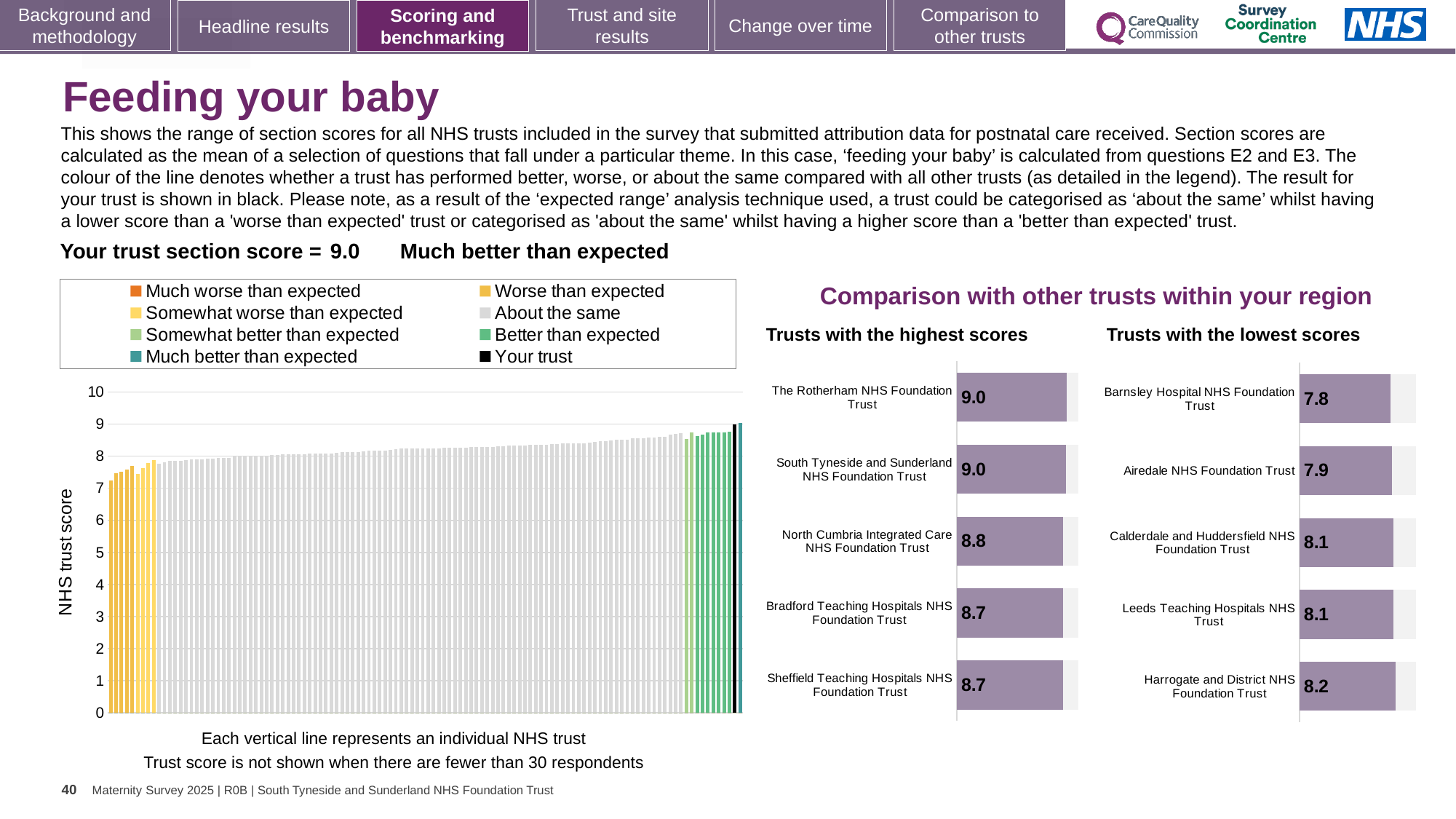
In the 'Trusts with the lowest scores' chart, what is the score for Leeds Teaching Hospitals NHS Trust? 8.1 How many trusts are shown in the 'Trusts with the highest scores' chart? 5 In the 'NHS trust score' chart on the left, is the value of the black 'Your trust' bar greater or less than 8? greater In the 'Trusts with the lowest scores' chart, what is the score for Barnsley Hospital NHS Foundation Trust? 7.8 In the 'Trusts with the lowest scores' chart, which has the larger score: Airedale NHS Foundation Trust or Harrogate and District NHS Foundation Trust? Harrogate and District NHS Foundation Trust In the 'NHS trust score' chart on the left, do the bar values rise or fall from left to right? Rise In the 'Trusts with the lowest scores' chart, which trust has the highest score? Harrogate and District NHS Foundation Trust In the 'Trusts with the lowest scores' chart, which trust has the lowest score? Barnsley Hospital NHS Foundation Trust How many entries does the legend above the 'NHS trust score' chart list? 8 In the 'Trusts with the highest scores' chart, what is the difference between the score for The Rotherham NHS Foundation Trust and the score for Sheffield Teaching Hospitals NHS Foundation Trust? 0.3 In the 'Trusts with the highest scores' chart, what is the score for North Cumbria Integrated Care NHS Foundation Trust? 8.8 What kind of chart is the 'NHS trust score' chart on the left of the slide? Bar chart